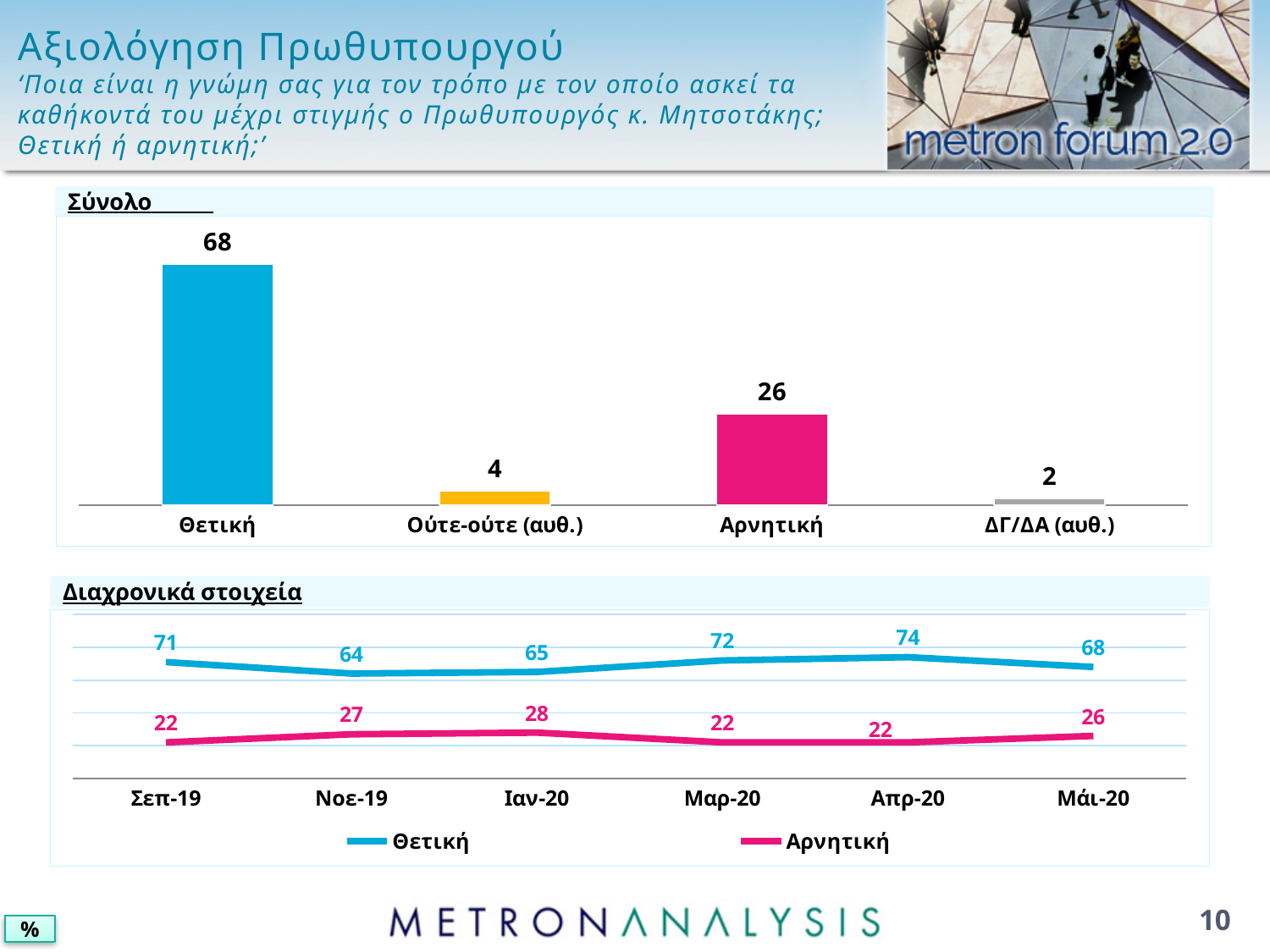
In the 'Διαχρονικά στοιχεία' line chart, what is the value of Αρνητική for Ιαν-20? 28 In the 'Σύνολο' bar chart, what is the value for Θετική? 68 In the 'Διαχρονικά στοιχεία' line chart, which is larger for Νοε-19: Θετική or Αρνητική? Θετική In the 'Διαχρονικά στοιχεία' line chart, does Θετική rise or fall from Απρ-20 to Μάι-20? fall In the 'Σύνολο' bar chart, what is the difference between Θετική and Αρνητική? 42 In the 'Διαχρονικά στοιχεία' line chart, how many series does the legend list? 2 In the 'Σύνολο' bar chart, which category has the lowest value? ΔΓ/ΔΑ (αυθ.) In the 'Σύνολο' bar chart, what is the value for Αρνητική? 26 In the 'Διαχρονικά στοιχεία' line chart, at which date is Θετική highest? Απρ-20 What kind of chart is the 'Σύνολο' chart? bar chart In the 'Διαχρονικά στοιχεία' line chart, what is the value of Θετική for Απρ-20? 74 In the 'Σύνολο' bar chart, how many categories are shown? 4